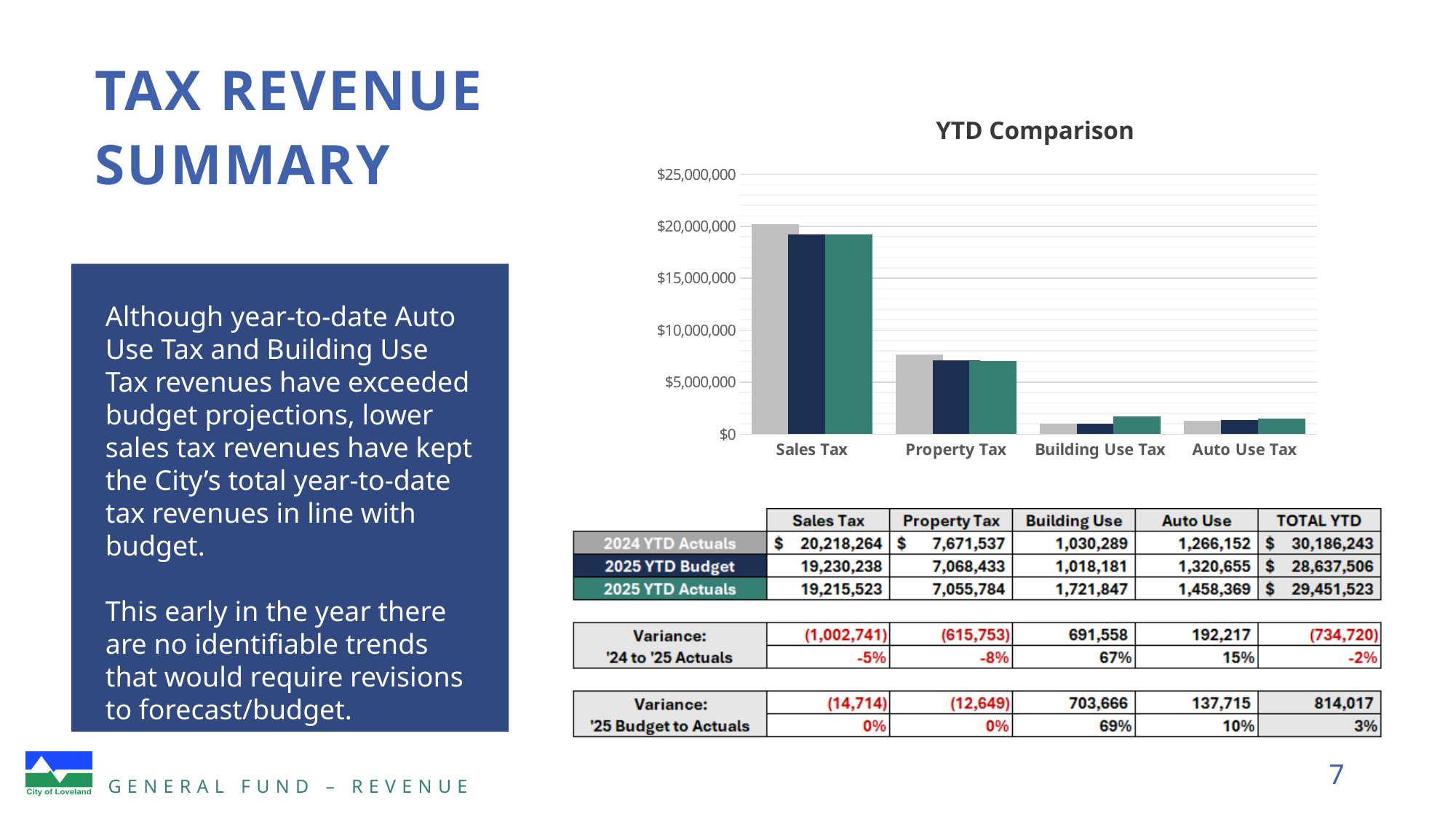
What is the 2024 YTD Actuals value for Sales Tax shown in the table? 20,218,264 How many tax categories are shown on the x axis of the chart? 4 According to the table, which category has the lowest 2024 YTD Actuals value? Building Use What kind of chart is shown on the slide? bar chart For Building Use Tax, which is larger: the 2025 YTD Budget bar or the 2025 YTD Actuals bar? 2025 YTD Actuals Which tax category has the highest bars in the chart? Sales Tax What is the 2025 YTD Actuals value for Building Use shown in the table? 1,721,847 How many bars (series) are plotted for each tax category in the chart? 3 Is the 2025 YTD Actuals bar for Sales Tax greater or less than $20,000,000? less What is the title of the chart? YTD Comparison What is the TOTAL YTD for 2025 YTD Actuals in the table? 29,451,523 What is the difference between the 2024 YTD Actuals and 2025 YTD Actuals for Sales Tax? 1,002,741